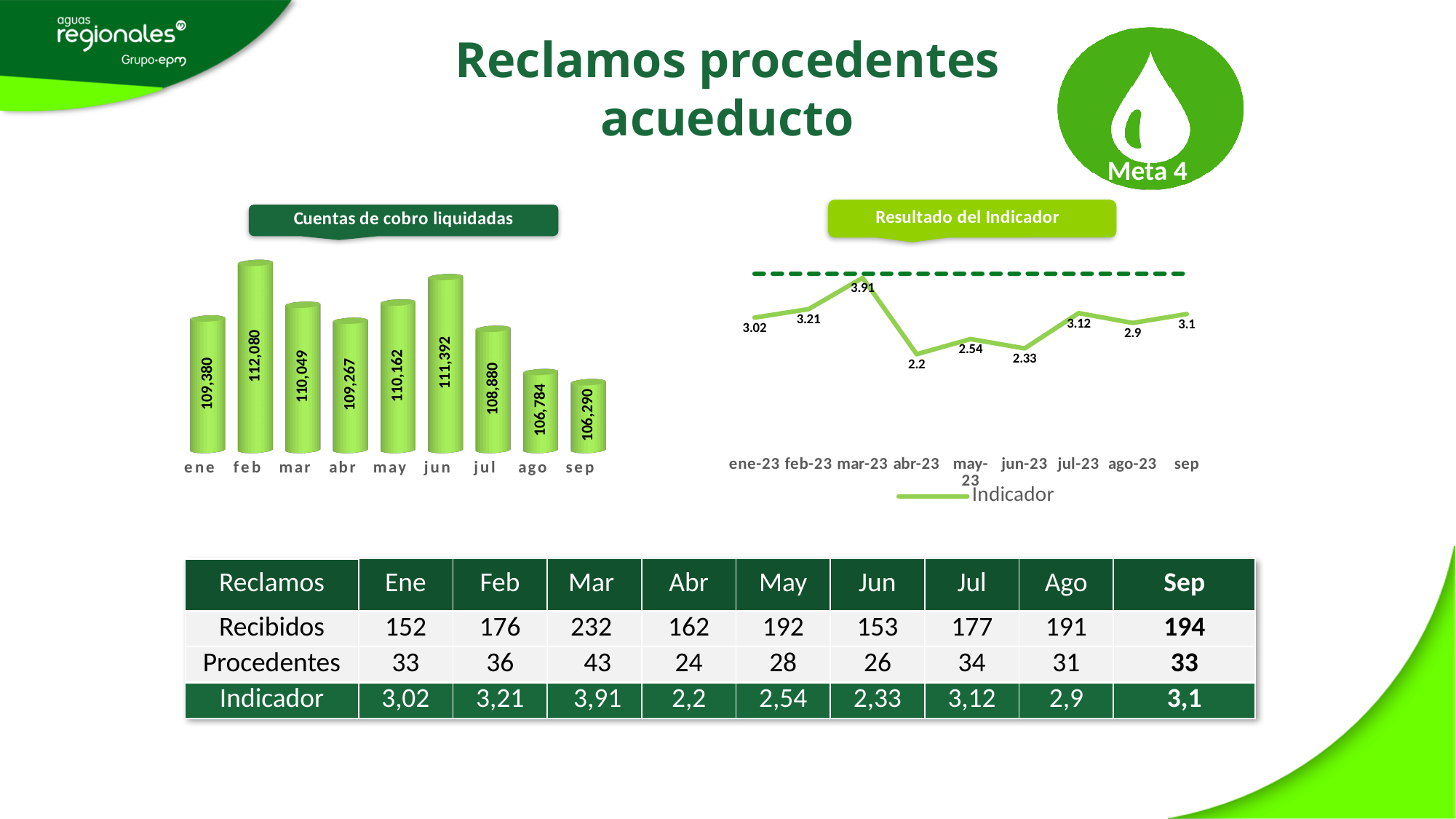
In the 'Cuentas de cobro liquidadas' chart, what is the difference between the values for feb and sep? 5,790 In the 'Cuentas de cobro liquidadas' chart, which month has the lowest value? sep In the 'Resultado del Indicador' chart, is the value for jul-23 or ago-23 larger? jul-23 In the 'Resultado del Indicador' chart, what is the value for mar-23? 3.91 In the 'Cuentas de cobro liquidadas' chart, how many months are shown? 9 In the 'Cuentas de cobro liquidadas' chart, which month has the highest value? feb What kind of chart is 'Resultado del Indicador'? line chart What kind of chart is 'Cuentas de cobro liquidadas'? bar chart In the 'Resultado del Indicador' chart, what series name does the legend show? Indicador In the 'Cuentas de cobro liquidadas' chart, what is the value for feb? 112,080 In the 'Resultado del Indicador' chart, which month has the lowest value? abr-23 In the 'Resultado del Indicador' chart, what is the difference between the values for mar-23 and abr-23? 1.71